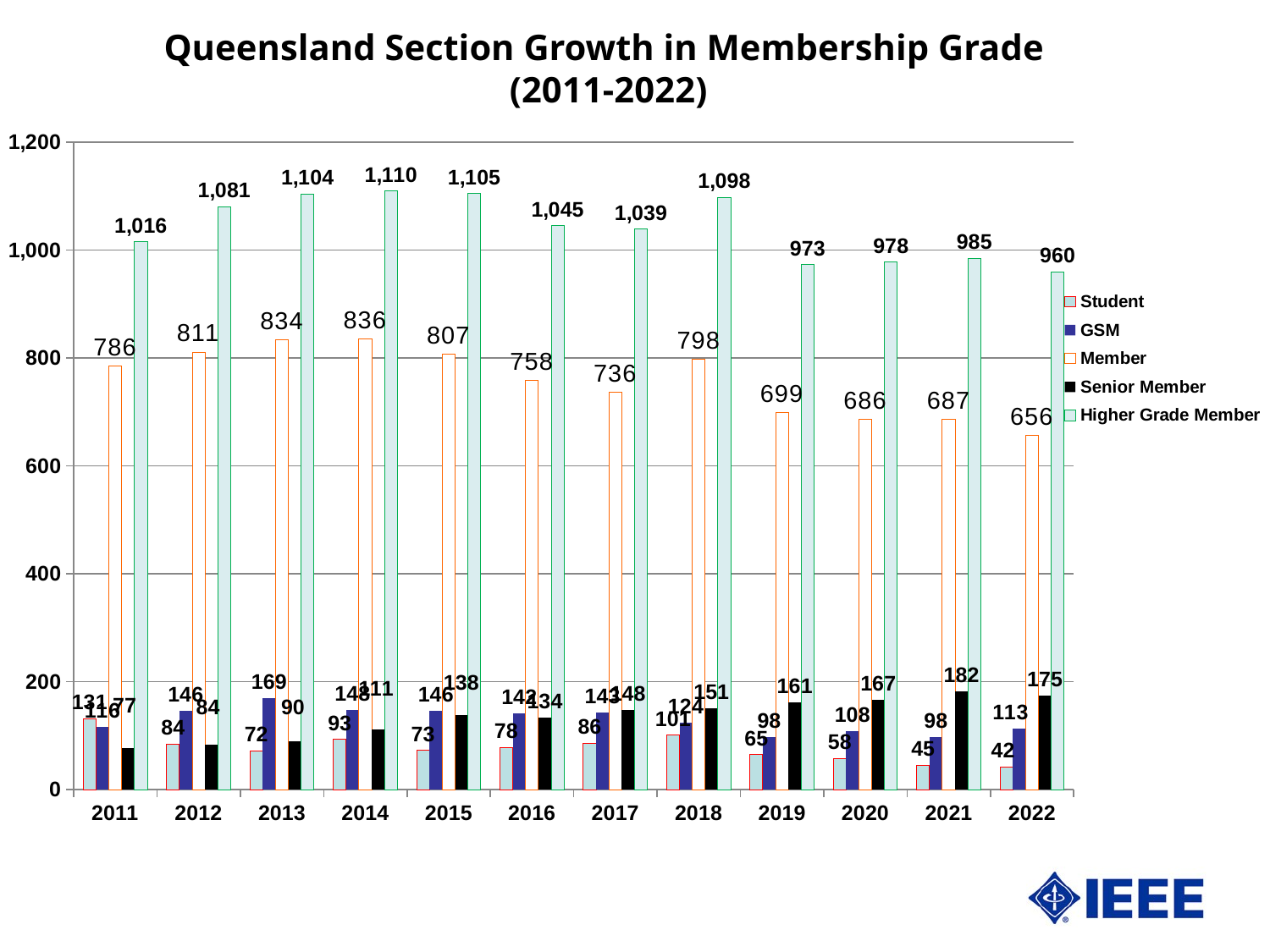
What is the Higher Grade Member value for 2014? 1,110 What is the Member value for 2011? 786 In which year is the Member value lowest? 2022 Which year has the larger Senior Member value, 2021 or 2022? 2021 What is the Student value for 2022? 42 What is the difference between the Higher Grade Member values for 2011 and 2022? 56 What kind of chart is shown on the slide? bar chart How many years are shown on the x axis? 12 Do the Student values rise or fall from 2018 to 2022? fall What is the Senior Member value for 2019? 161 How many series does the legend list? 5 In which year is the Higher Grade Member value highest? 2014